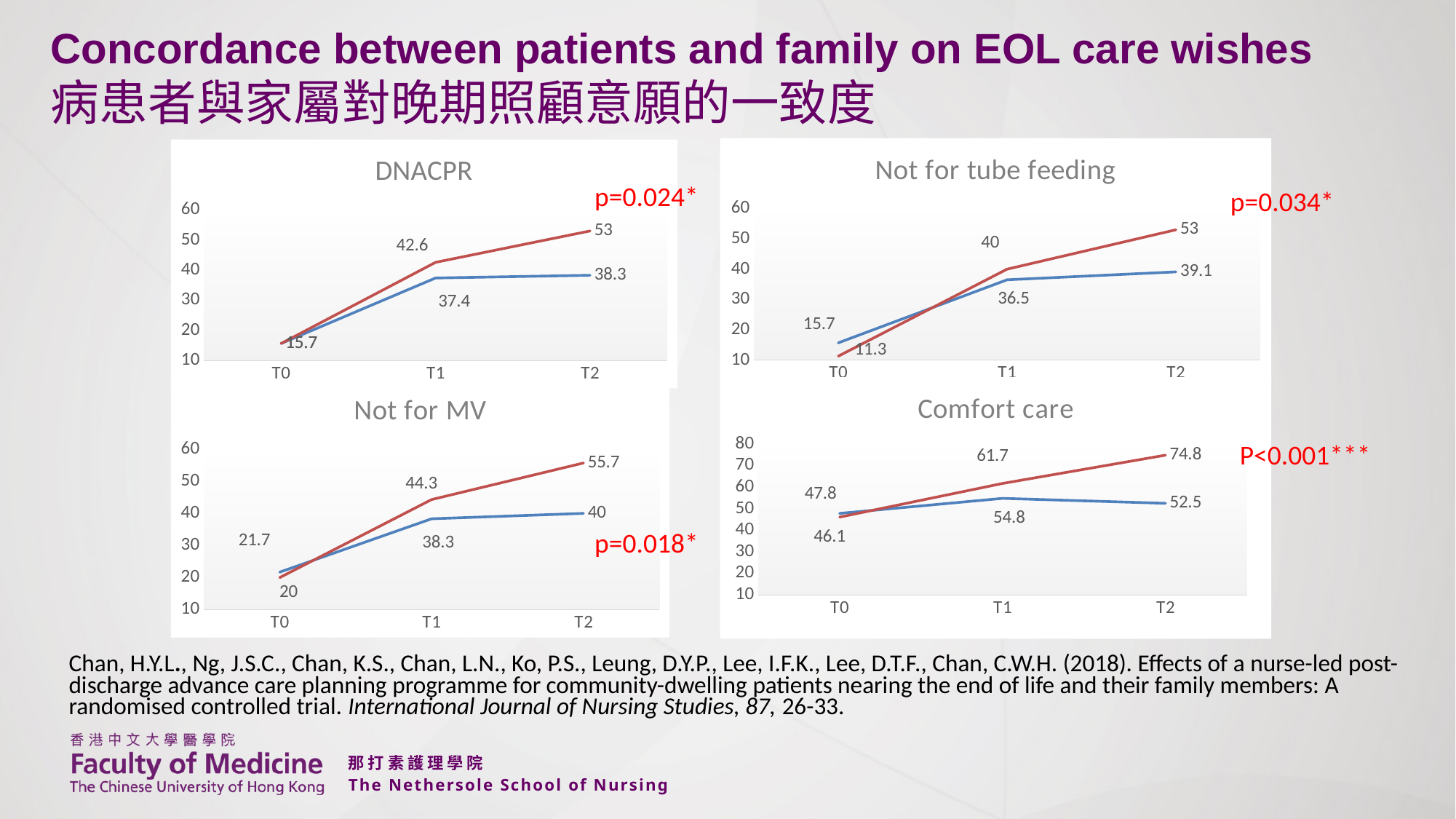
In the Comfort care chart, what is the value of the red line at T2? 74.8 What type of chart is the Comfort care chart? line chart In the DNACPR chart, what is the value of the blue line at T1? 37.4 What p-value is shown next to the Not for tube feeding chart? p=0.034* In the DNACPR chart, what is the value of the red line at T2? 53 In the DNACPR chart, does the red line rise or fall from T0 to T2? rise In the Not for tube feeding chart, what is the value of the red line at T0? 11.3 In the Not for MV chart, what is the value of the blue line at T2? 40 In the Not for MV chart, which line has the higher value at T1, red or blue? red How many time points are shown on the x axis of the DNACPR chart? 3 In the Not for tube feeding chart, at which time point does the red line reach its highest value? T2 In the Comfort care chart, what is the difference between the red and blue lines at T2? 22.3